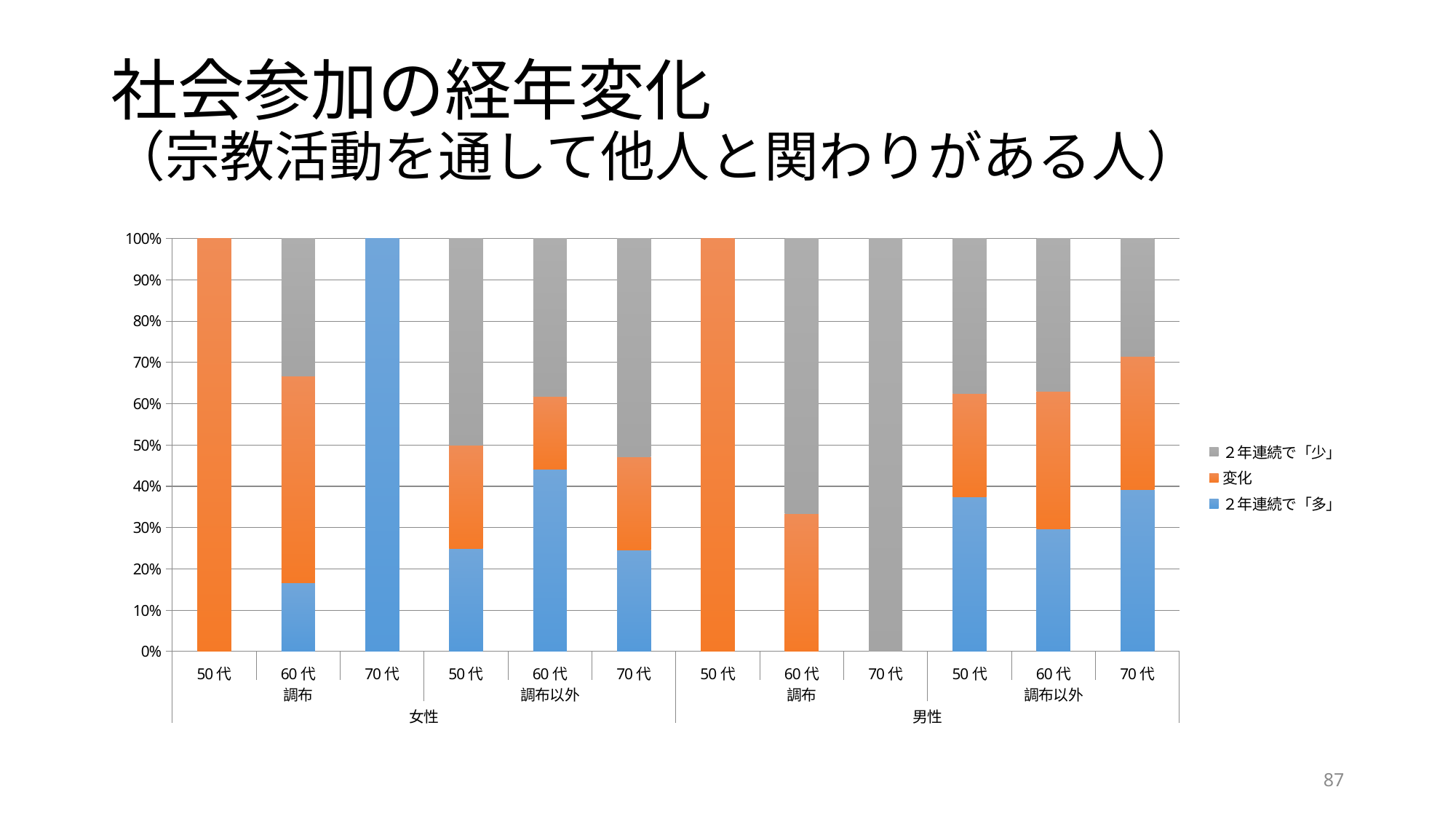
Which has the larger 2年連続で「多」 segment: 女性 調布以外 60代 or 女性 調布以外 70代? 女性 調布以外 60代 Is the value of 2年連続で「多」 for 男性 調布以外 70代 greater or less than 30%? greater How many bars are plotted in the chart? 12 Is the value of 2年連続で「多」 for 男性 調布以外 50代 greater or less than 40%? less How many series does the legend list? 3 Is the value of 2年連続で「多」 for 女性 調布 60代 greater or less than 20%? less What is the value of 変化 for 女性 調布 50代? 100% Which bar has the largest 2年連続で「多」 segment? 女性 調布 70代 What is the value of 2年連続で「少」 for 男性 調布 70代? 100% Which legend entry is shown in gray? 2年連続で「少」 What kind of chart is shown on the slide? Stacked bar chart What is the value of 2年連続で「多」 for 女性 調布 70代? 100%